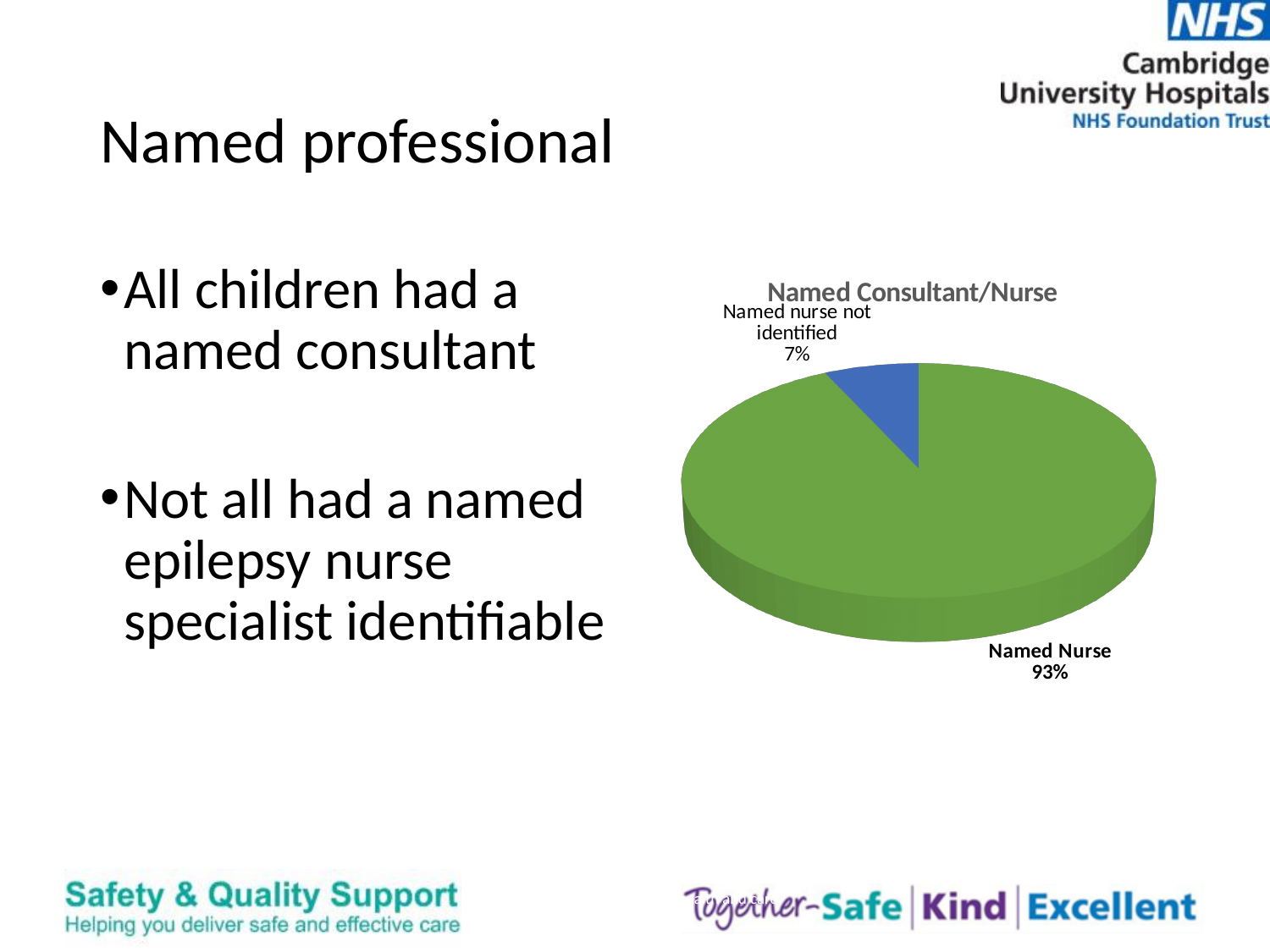
What share of the pie does the 'Named Nurse' slice represent? 93% How many slices does the pie chart have? 2 Which slice of the pie chart is the smallest? Named nurse not identified Which is larger: the 'Named Nurse' slice or the 'Named nurse not identified' slice? Named Nurse What is the title of the chart? Named Consultant/Nurse What colour is the 'Named Nurse' slice of the pie chart? Green What kind of chart is shown on the slide? Pie chart What share of the pie does the 'Named nurse not identified' slice represent? 7% Which slice of the pie chart is the largest? Named Nurse What is the difference in percentage points between the 'Named Nurse' slice and the 'Named nurse not identified' slice? 86 percentage points